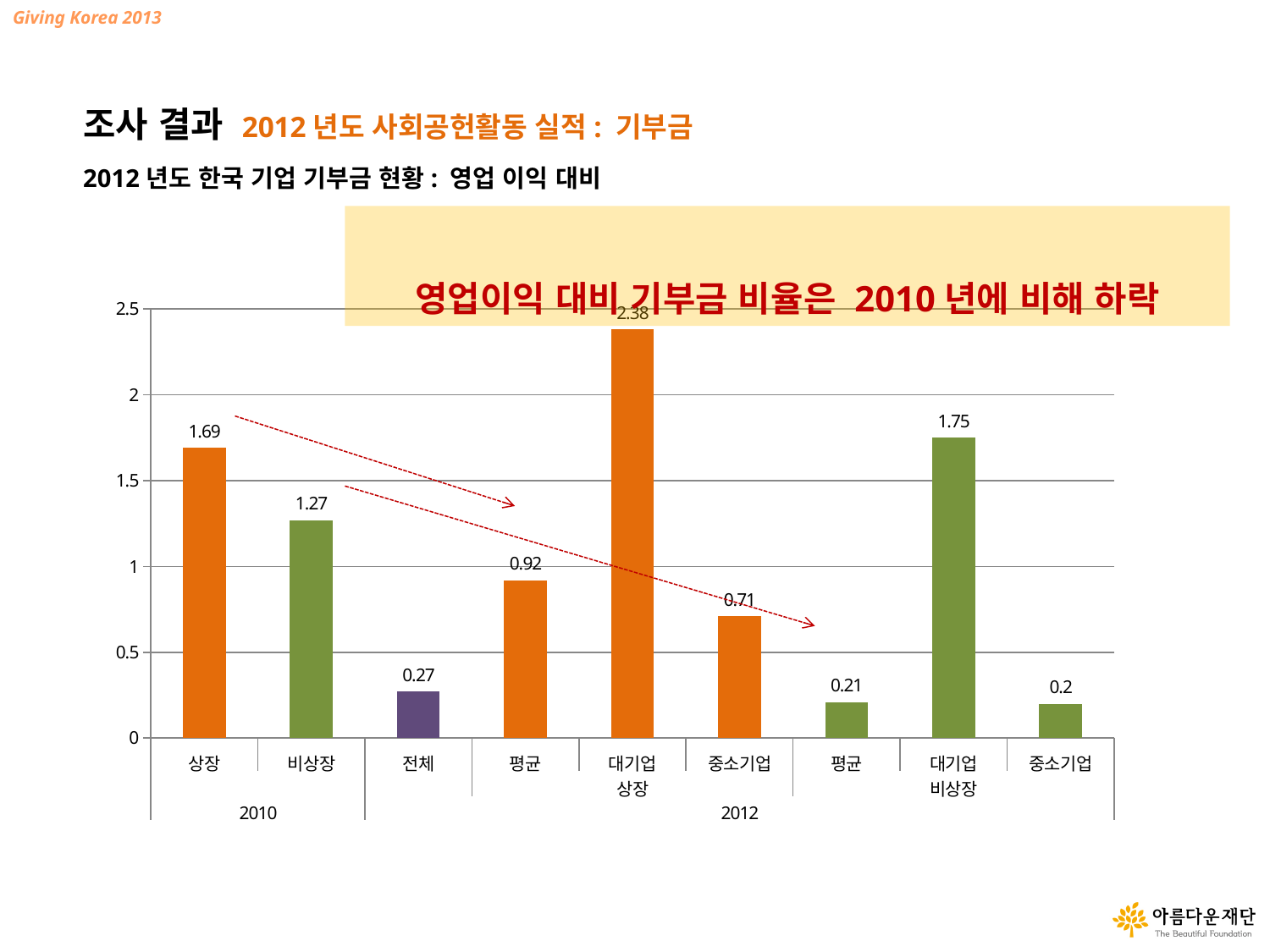
What is the value for 상장 in 2010? 1.69 Which category has the lowest value in the chart? 중소기업 (비상장, 2012) Which is larger: the value for 대기업 상장 or the value for 대기업 비상장? 대기업 상장 What is the value for 대기업 상장 in 2012? 2.38 How many bars are plotted in the chart? 9 What type of chart is shown on the slide? bar chart What is the value for 전체 in 2012? 0.27 What is the difference between the 2012 평균 value for 상장 (0.92) and the 2012 평균 value for 비상장 (0.21)? 0.71 What is the value for 대기업 비상장 in 2012? 1.75 What is the value for 비상장 in 2010? 1.27 Which category has the highest value in the chart? 대기업 상장 What is the difference between the 2010 상장 value (1.69) and the 2010 비상장 value (1.27)? 0.42